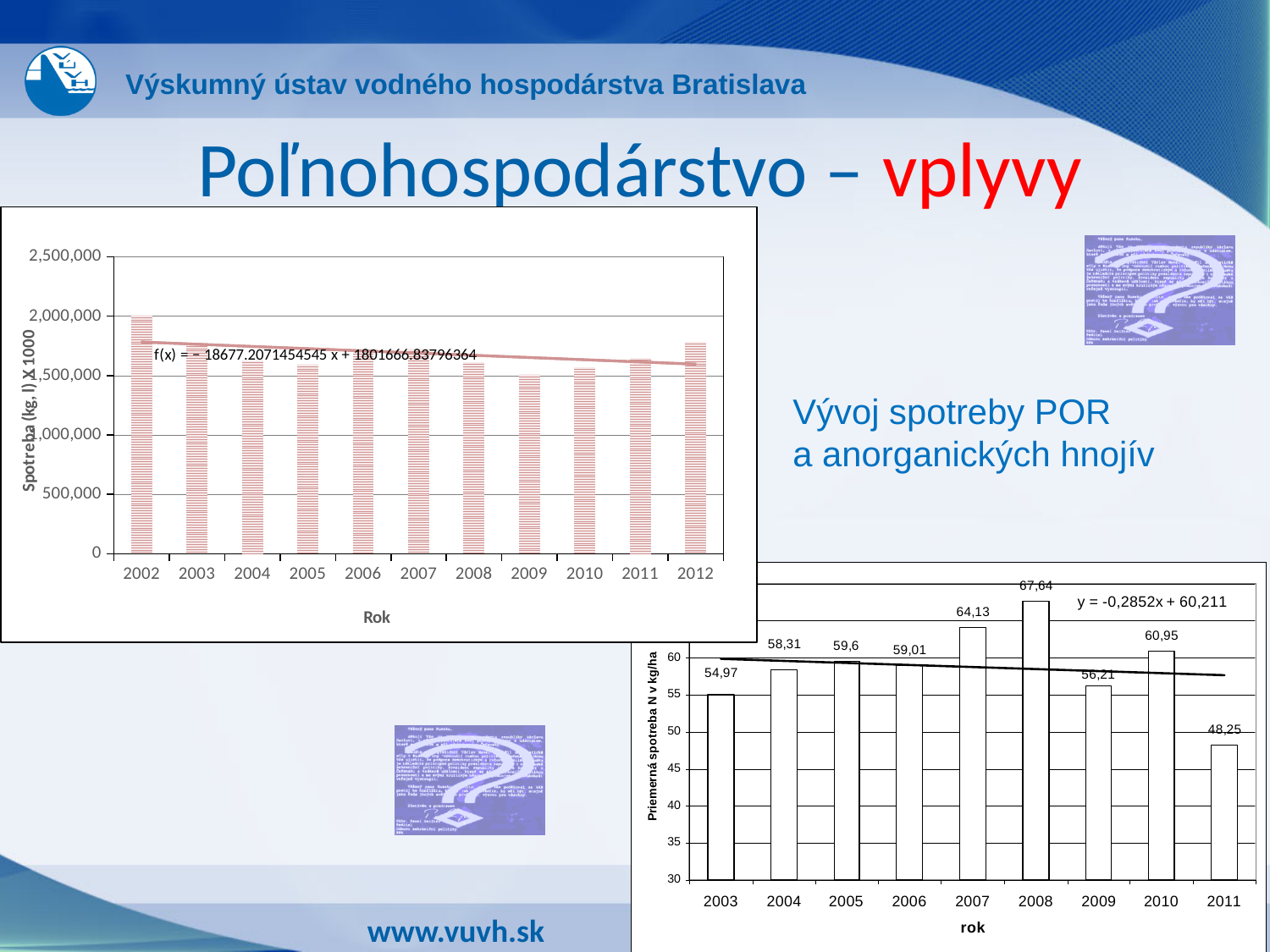
In the bottom-right chart, what is the difference between the values for 2008 and 2011? 19,39 In the bottom-right chart, what is the value for 2011? 48,25 In the bottom-right chart, which year has the highest value? 2008 In the top-left chart, which year has the highest value? 2002 In the bottom-right chart, which is larger, the value for 2007 or the value for 2010? 2007 What is the label of the y axis of the bottom-right chart? Priemerná spotreba N v kg/ha In the bottom-right chart, which year has the lowest value? 2011 In the bottom-right chart, what is the value for 2003? 54,97 How many years are shown on the x axis of the top-left chart? 11 How many years are shown on the x axis of the bottom-right chart? 9 In the bottom-right chart, what is the value for 2008? 67,64 In the top-left chart, is the value for 2002 greater or less than 1,500,000? greater